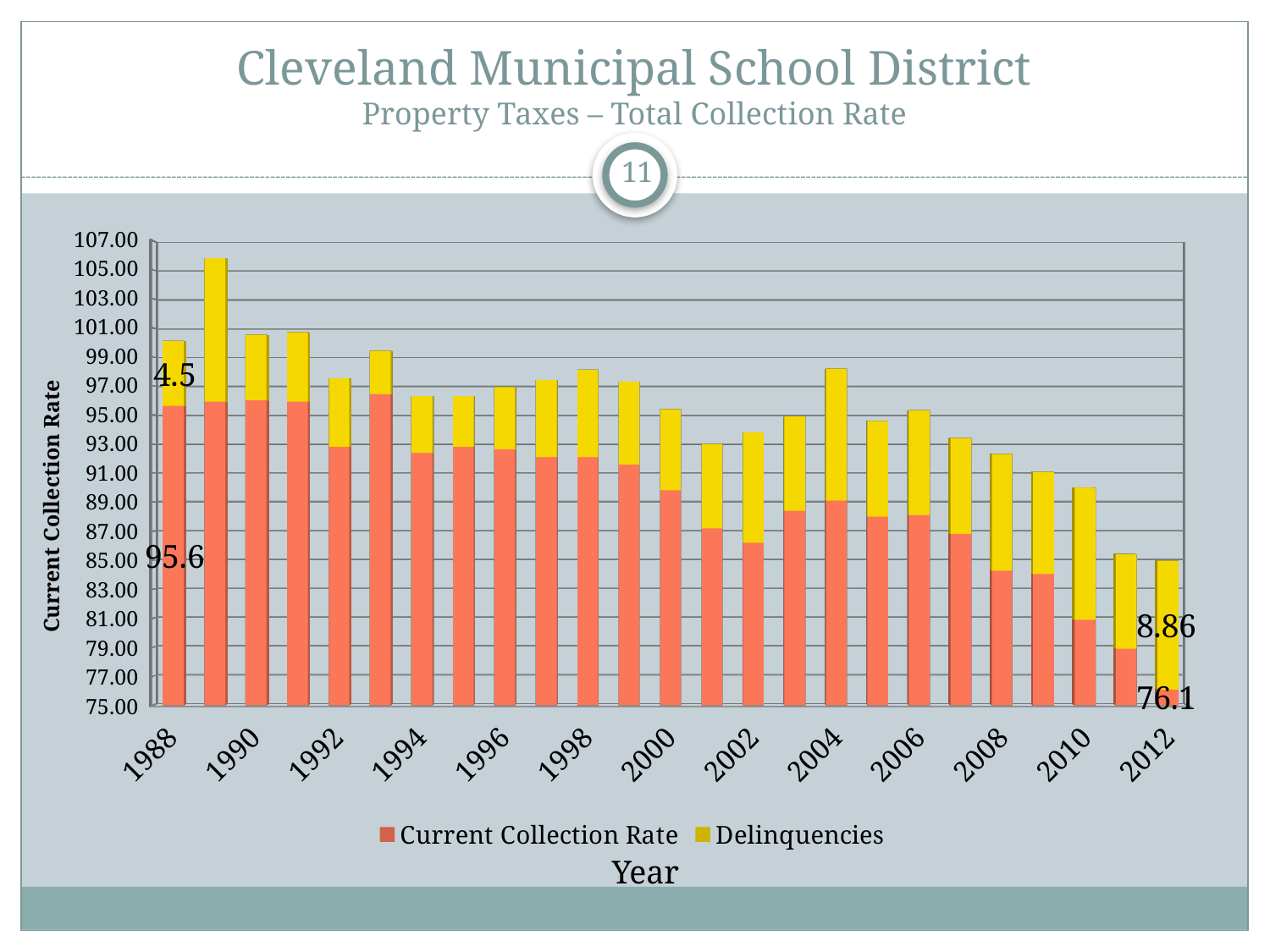
Which year has the lowest Current Collection Rate? 2012 How many series does the legend list? 2 What kind of chart is shown on the slide? Stacked bar chart Does the Current Collection Rate generally rise or fall from 1988 to 2012? Fall What is the Current Collection Rate for 1988? 95.6 Is the Current Collection Rate for 2010 greater or less than 83.00? less What is the title of the x axis? Year What is the Current Collection Rate for 2012? 76.1 What is the Delinquencies value for 1988? 4.5 What is the difference between the Current Collection Rate in 1988 and in 2012? 19.5 What is the Delinquencies value for 2012? 8.86 What is the total of the stacked bar for 1988 (Current Collection Rate plus Delinquencies)? 100.1